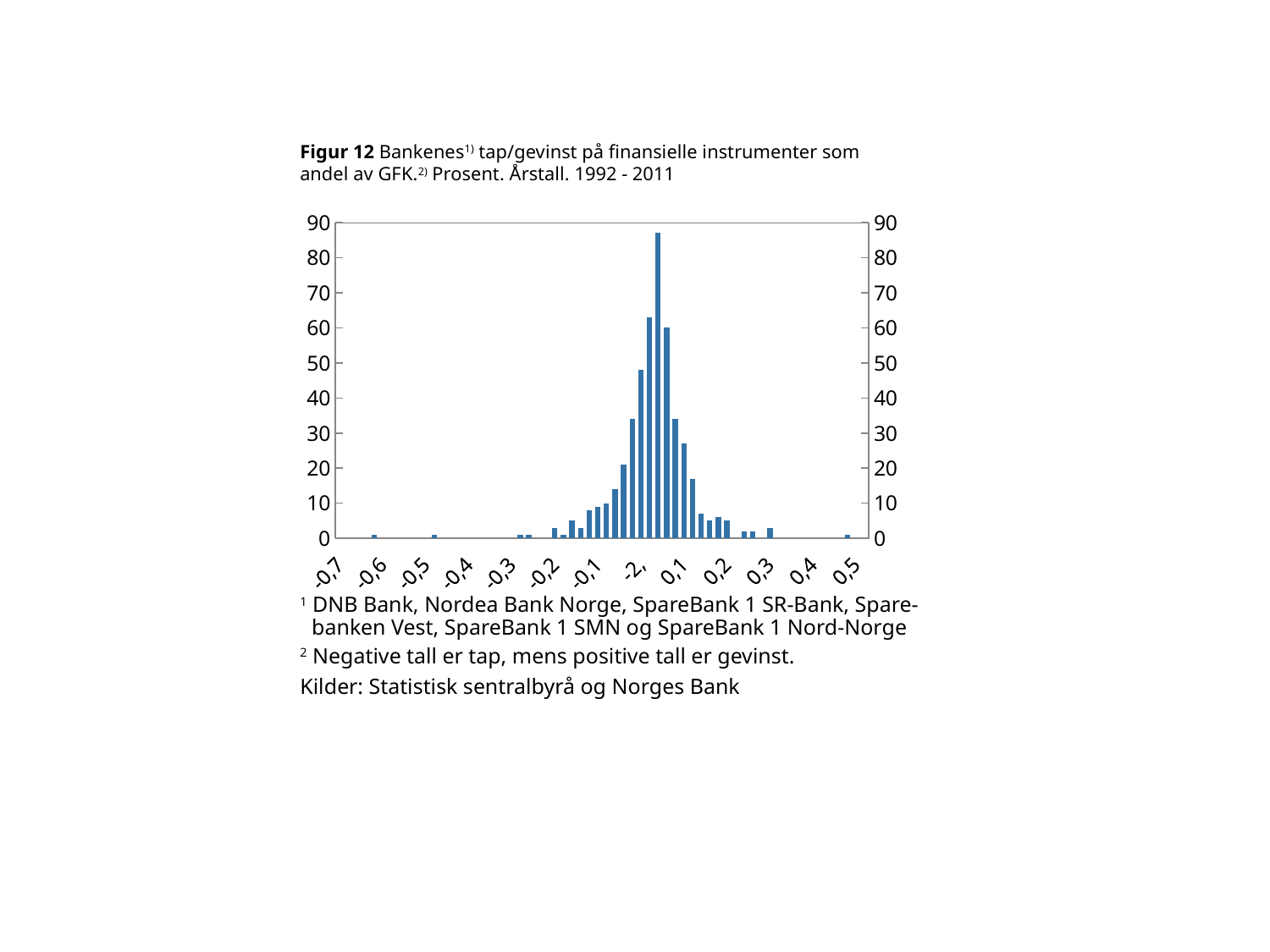
What period does the chart title say the data covers? 1992 - 2011 Is the value of the bar at -0,5 greater or less than 10? less How many labelled tick marks are shown on the x axis? 13 What kind of chart is shown on the slide? bar chart Is the value of the tallest bar greater or less than 80? greater Is the value of the bar at 0,5 greater or less than 10? less What is the highest value shown on the y axis? 90